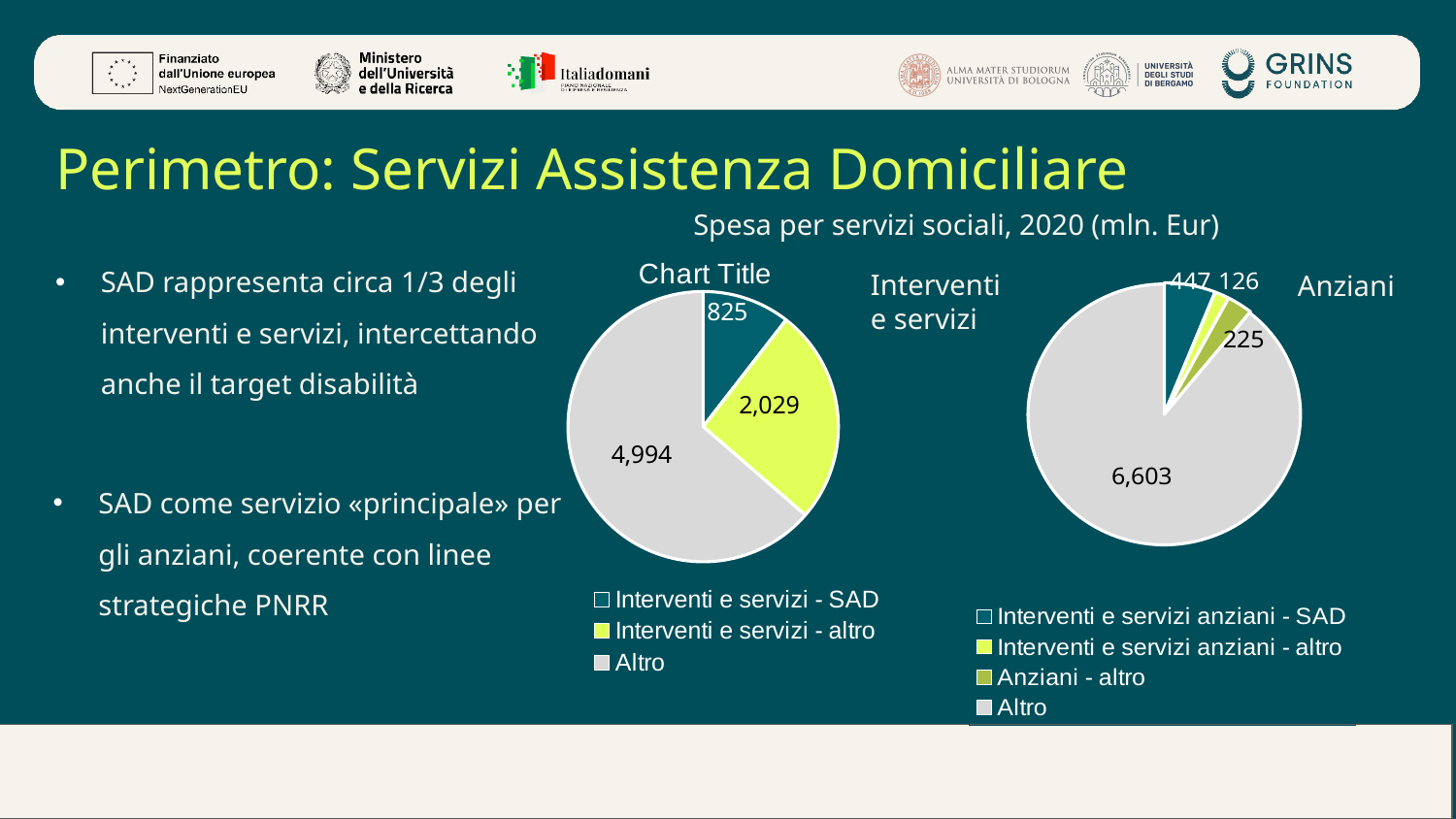
How many categories does the legend of the right pie chart (Anziani) list? 4 In the right pie chart (Anziani), what is the value for Altro? 6,603 In the left pie chart (Interventi e servizi), what is the value for Interventi e servizi - SAD? 825 In the right pie chart (Anziani), what is the value for Interventi e servizi anziani - SAD? 447 What is the total of all slices in the right pie chart (Anziani)? 7,401 What type of chart is used on the left (Interventi e servizi)? Pie chart In the right pie chart (Anziani), which is larger: Interventi e servizi anziani - SAD or Anziani - altro? Interventi e servizi anziani - SAD In the left pie chart (Interventi e servizi), what is the value for Interventi e servizi - altro? 2,029 In the left pie chart (Interventi e servizi), which category has the largest value? Altro In the left pie chart (Interventi e servizi), what is the value for Altro? 4,994 In the right pie chart (Anziani), which category has the smallest value? Interventi e servizi anziani - altro In the left pie chart (Interventi e servizi), what is the difference between Altro and Interventi e servizi - altro? 2,965